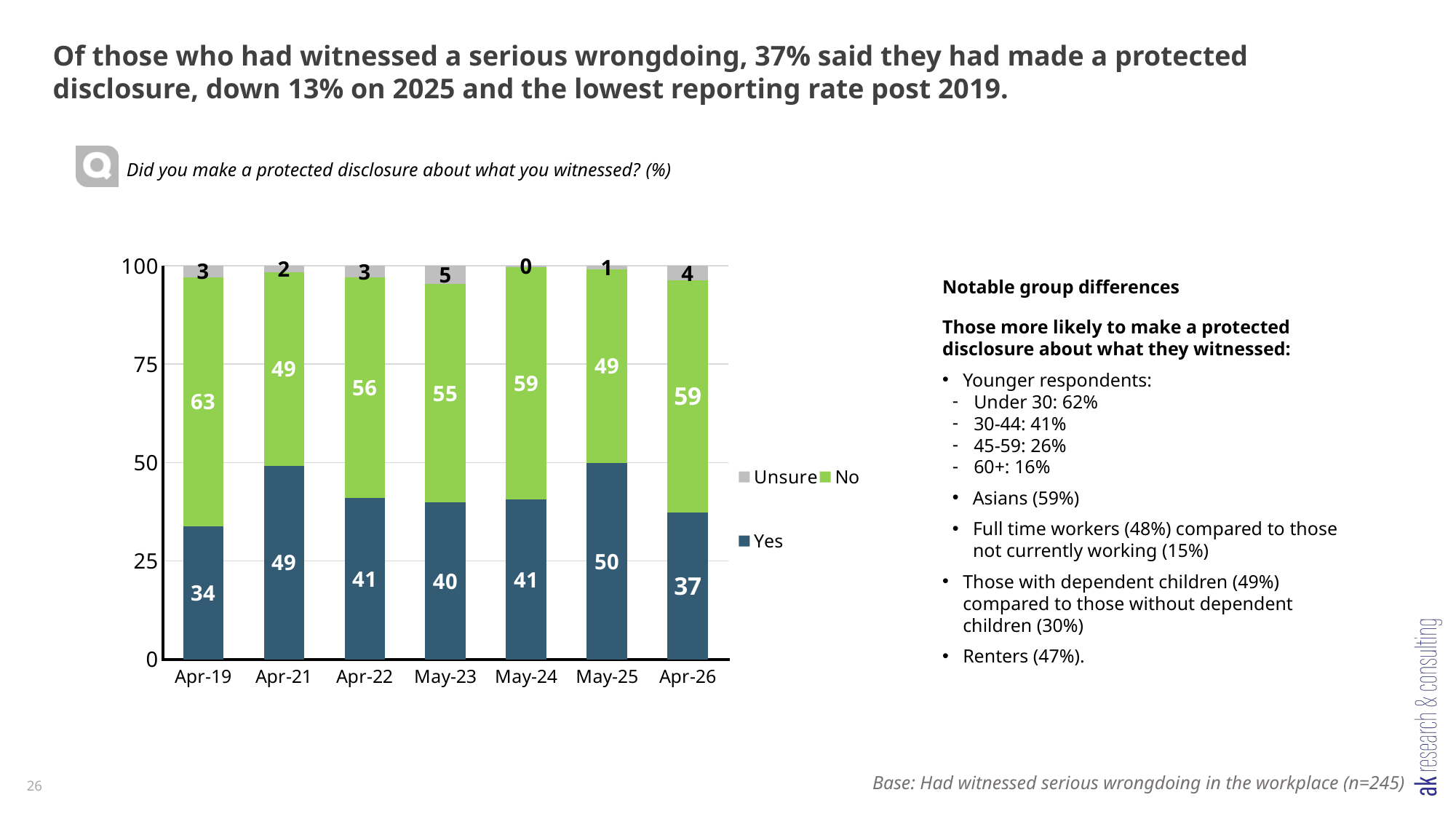
What is the 'Unsure' value for May-23? 5 What is the total of the stacked bar for Apr-26? 100 What is the 'No' value for Apr-19? 63 How many time points are shown on the x axis? 7 Which time point has the lowest 'Yes' value? Apr-19 What is the difference between the 'Yes' value for May-25 and the 'Yes' value for Apr-26? 13 What kind of chart is shown on the slide? Stacked bar chart Which time point has the highest 'No' value? Apr-19 How many series does the legend list? 3 Is the 'Yes' value larger in Apr-21 or in Apr-22? Apr-21 What percentage of respondents answered 'Yes' in Apr-26? 37 Which time point has the lowest 'Unsure' value? May-24